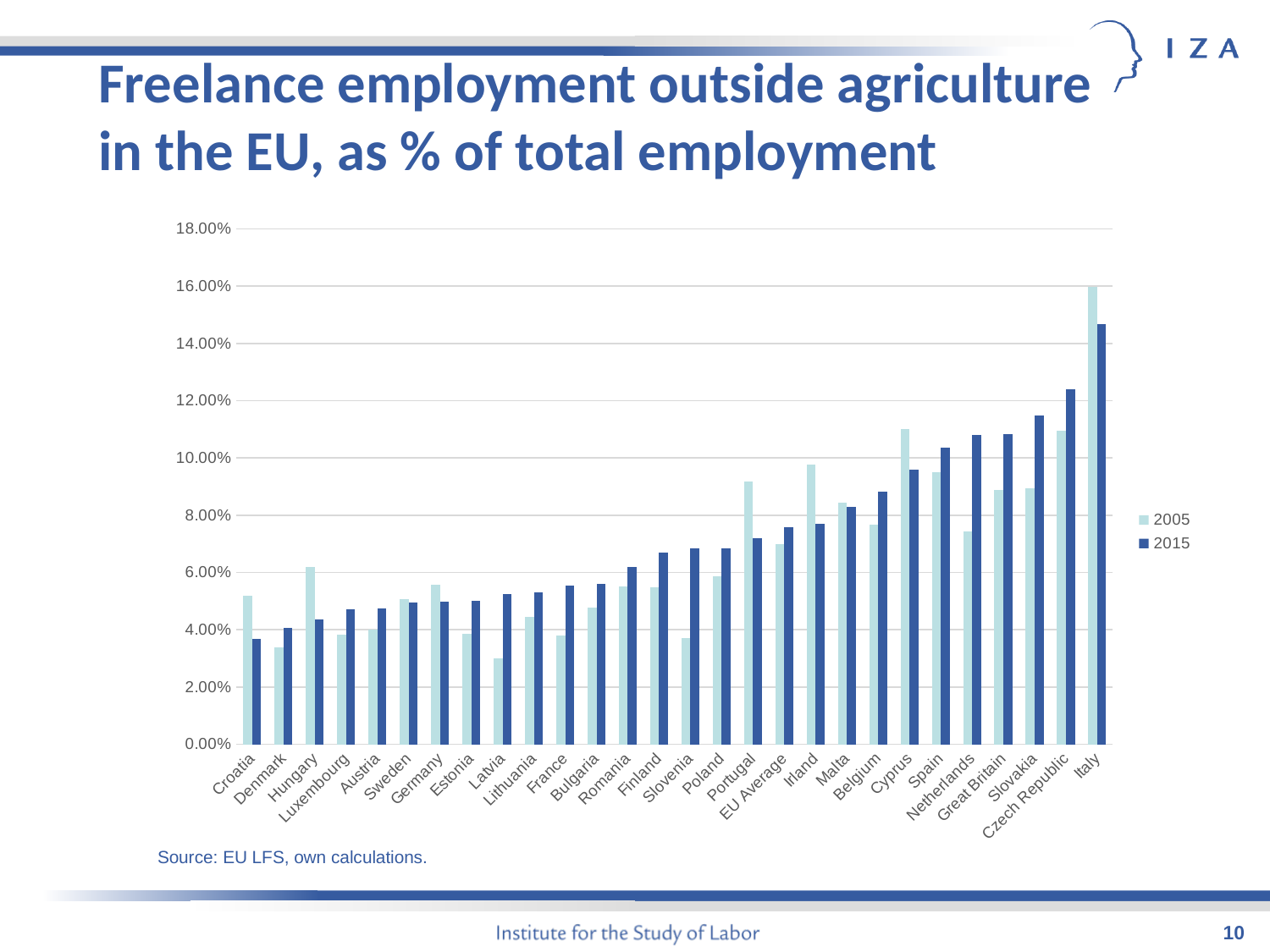
How many countries/categories are shown on the x axis? 28 What kind of chart is shown on the slide? bar chart Is the 2005 value for Latvia greater or less than 4.00%? less Is the 2005 value for Italy greater or less than 14.00%? greater Which category has the highest value for 2015? Italy Which category has the highest value for 2005? Italy Do the 2015 values generally rise or fall moving from left to right along the x axis? rise For Czech Republic, which is larger: the 2005 value or the 2015 value? 2015 For Hungary, which is larger: the 2005 value or the 2015 value? 2005 Which category has the lowest value for 2005? Latvia Is the 2015 value for Czech Republic greater or less than 10.00%? greater How many series does the legend list? 2